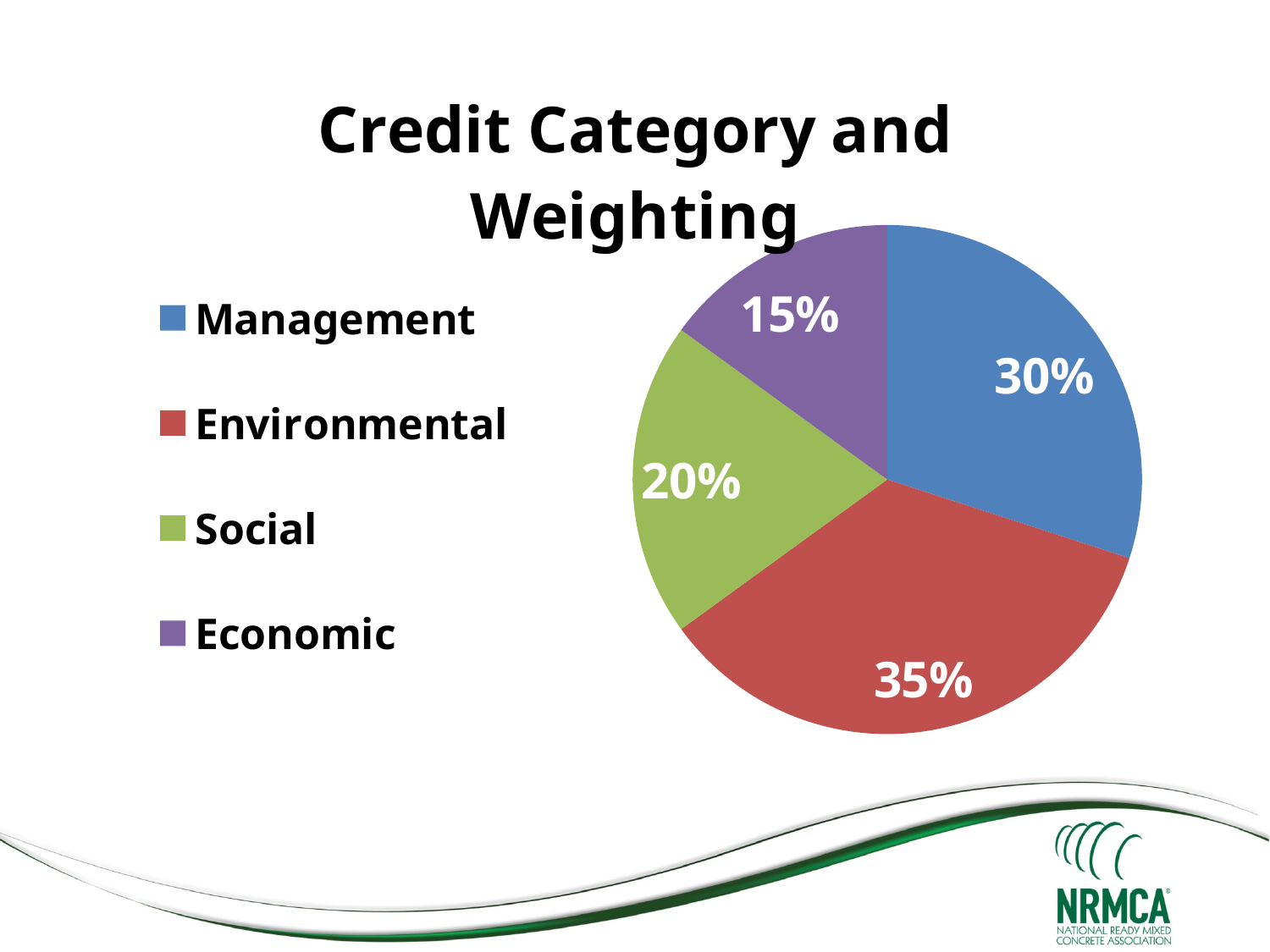
What kind of chart is shown on the slide? pie chart What is the weighting for Social? 20% What is the weighting for Management? 30% Which category has the smallest share of the pie? Economic What is the weighting for Economic? 15% What is the weighting for Environmental? 35% Which category has the largest share of the pie? Environmental Which colour represents Social in the pie chart? green What is the difference between the Environmental and Social weightings? 15% How many categories does the pie chart show? 4 Which is larger, the Management share or the Economic share? Management What is the title of the chart? Credit Category and Weighting